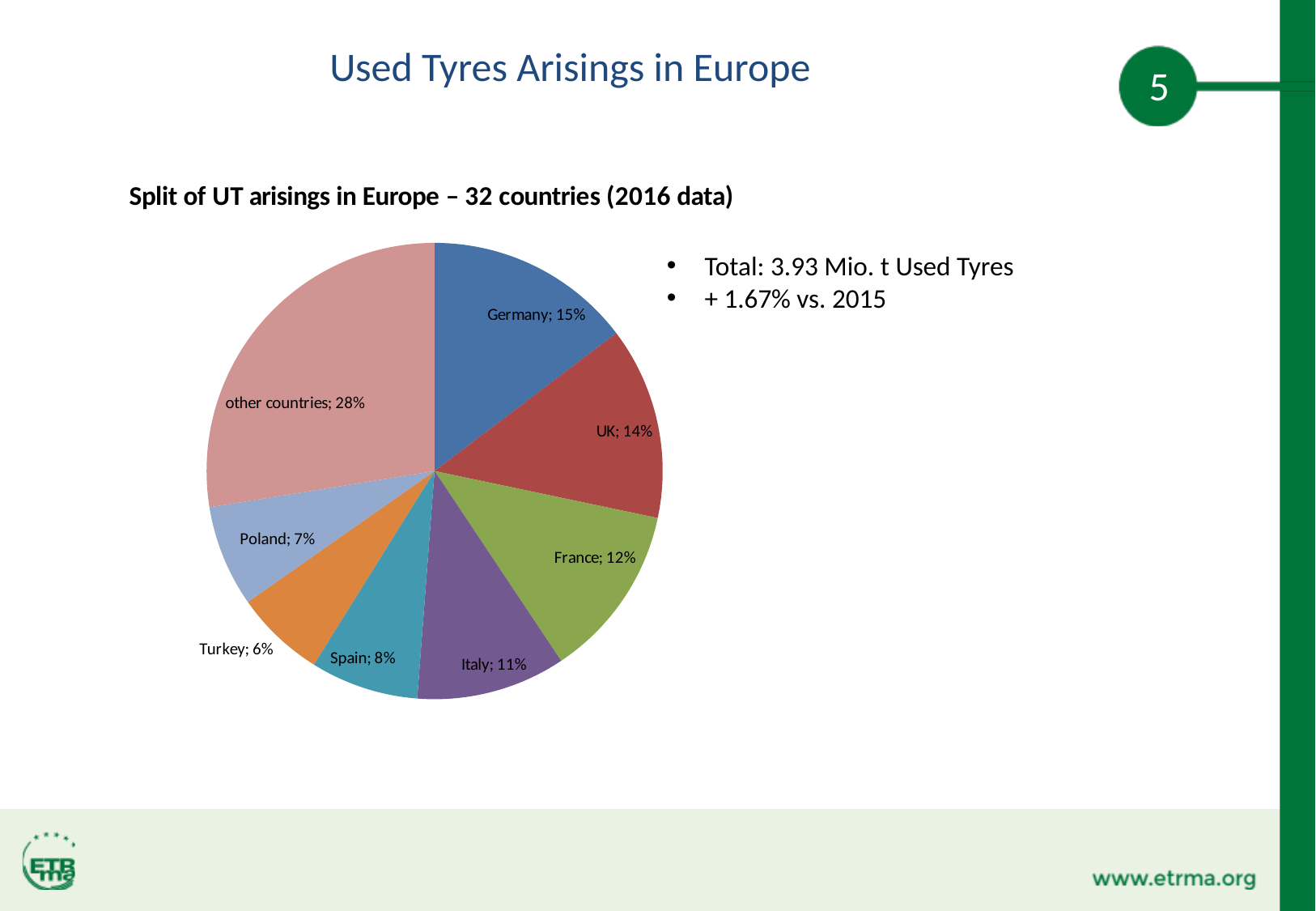
What is the combined share of Germany and the UK? 29% Which named country has the smallest share in the pie? Turkey What share of used tyre arisings does Germany account for? 15% What kind of chart is shown on the slide? pie chart What share of used tyre arisings does the UK account for? 14% What share of used tyre arisings does Turkey account for? 6% What is the title printed above the pie chart? Split of UT arisings in Europe – 32 countries (2016 data) What share of used tyre arisings does Spain account for? 8% What is the difference in percentage points between France's share and Italy's share? 1% Which has a larger share, Poland or Spain? Spain Which slice of the pie is the largest? other countries How many slices does the pie chart have? 8